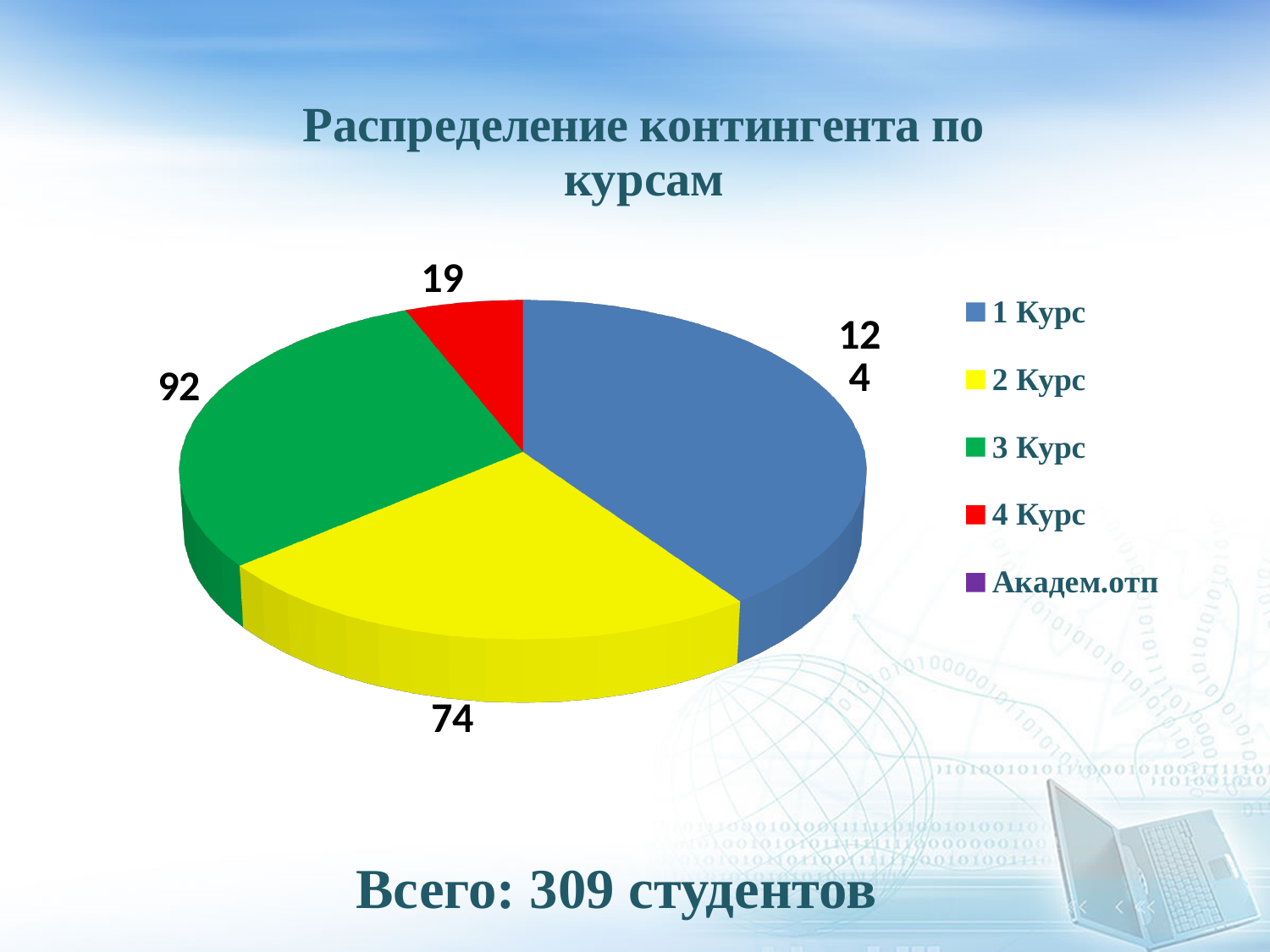
Which is larger, the value for 2 Курс or the value for 3 Курс? 3 Курс What is the value for 4 Курс? 19 Which course has the largest slice of the pie? 1 Курс What is the value for 2 Курс? 74 Which course has the smallest visible slice of the pie? 4 Курс What kind of chart is shown on the slide? pie chart What is the value for 1 Курс? 124 What is the value for 3 Курс? 92 What total number of students is stated below the chart? 309 What is the title of the chart? Распределение контингента по курсам How many entries does the legend list? 5 What is the difference between the values for 3 Курс and 2 Курс? 18